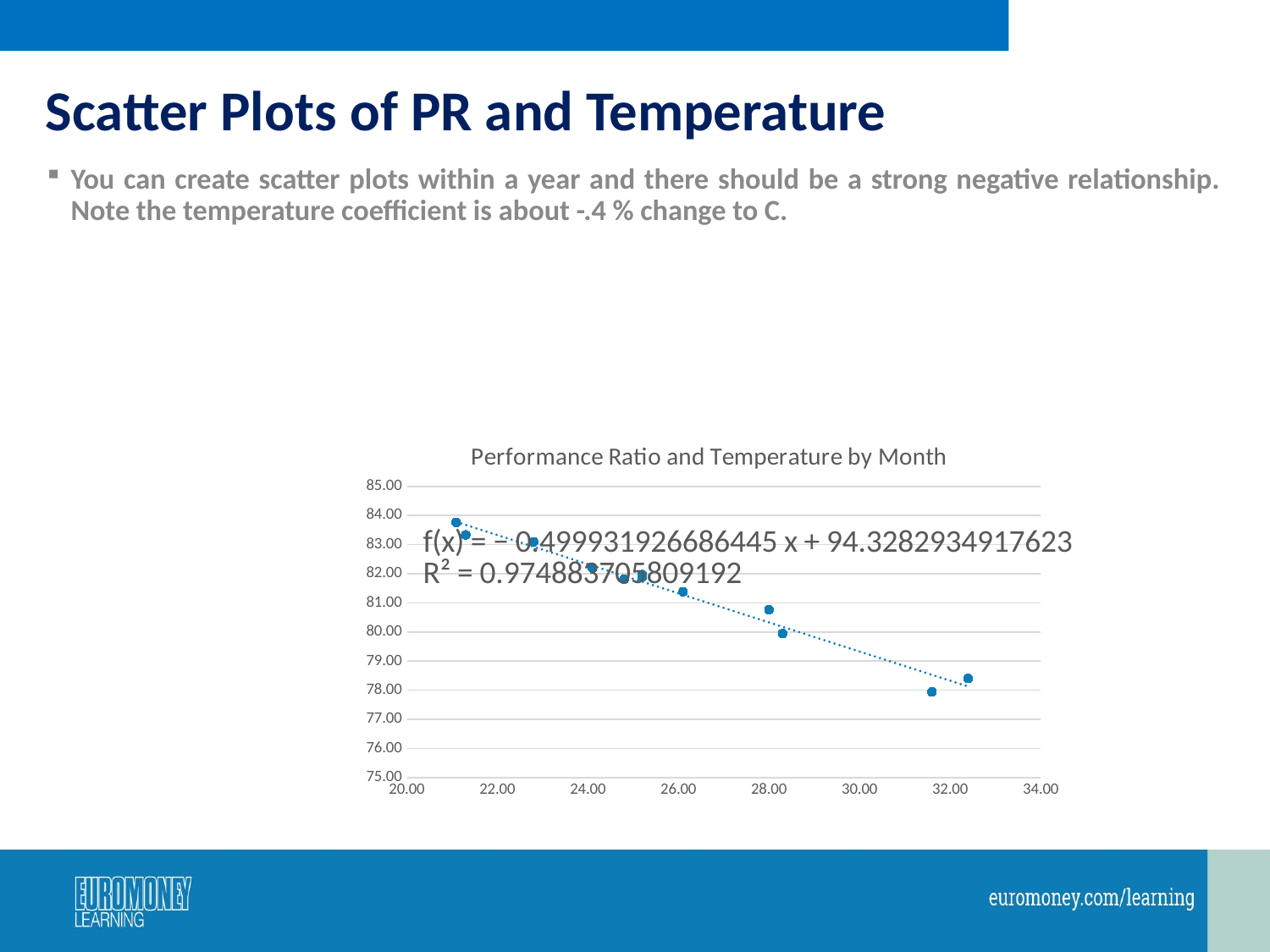
Is the highest performance ratio plotted greater or less than 83.00? greater Is the highest performance ratio plotted greater or less than 84.00? less What is the intercept shown in the trendline equation on the chart? 94.3282934917623 Which has the higher performance ratio: the point plotted near 21 on the x axis or the point plotted near 28 on the x axis? The point near 21 As temperature increases along the x axis, do the performance ratio values rise or fall? Fall Is the slope of the fitted trendline positive or negative? Negative What is the title of the chart? Performance Ratio and Temperature by Month Is the performance ratio of the point plotted at about 26 on the x axis greater or less than 81.00? greater What is the lowest value shown on the y axis of the chart? 75.00 What kind of chart is shown on the slide? Scatter plot